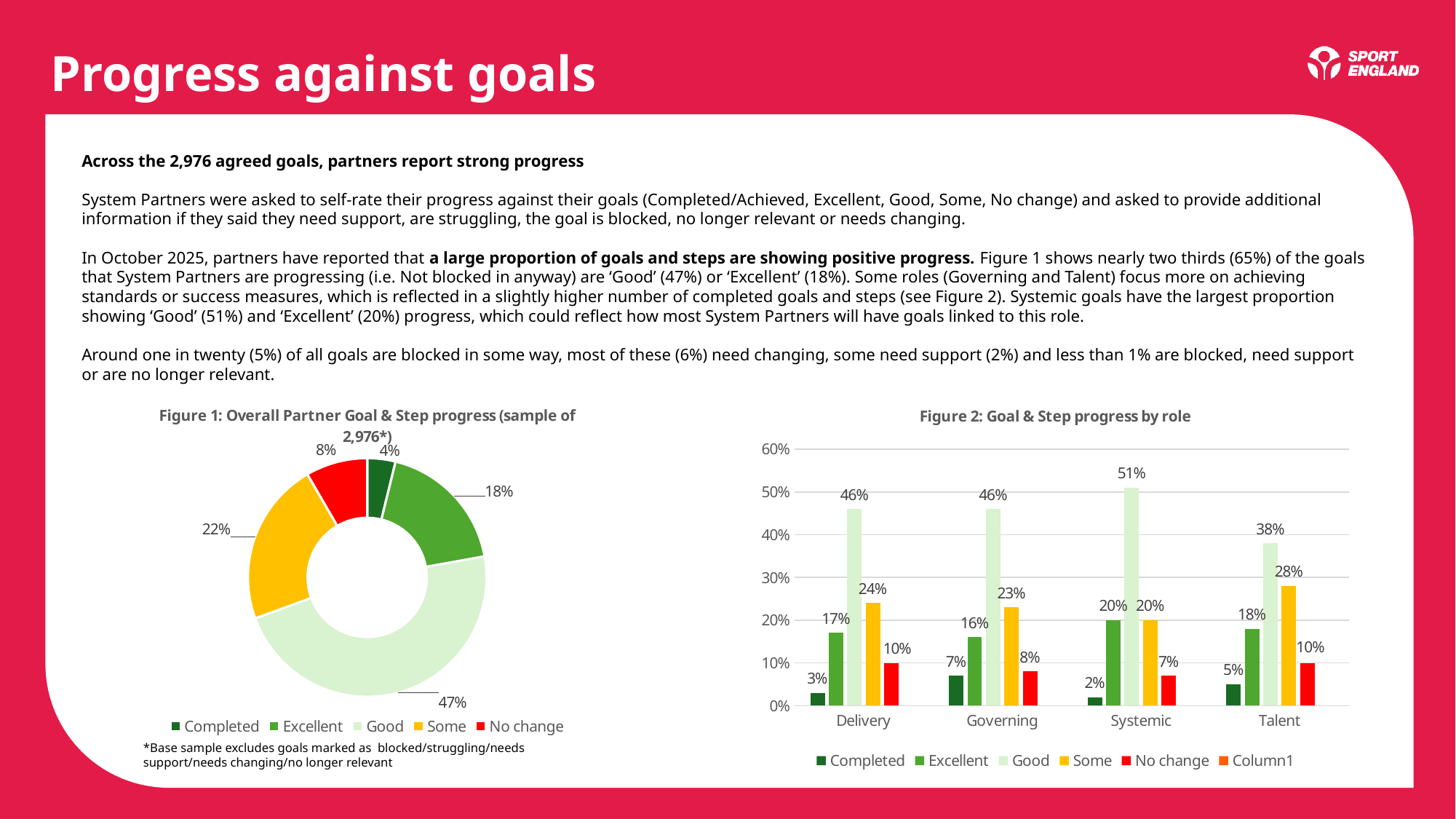
In Figure 1, what is the difference between the 'Some' and 'No change' slices? 14% In Figure 2, what is the 'Some' value for Talent? 28% In Figure 1, what percentage of goals are rated 'Completed'? 4% How many entries does the legend of Figure 2 list? 6 How many roles are shown on the x axis of Figure 2? 4 In Figure 2, which role has the lowest 'Completed' value? Systemic In Figure 2, what is the 'Good' value for Systemic? 51% In Figure 2, what is the difference between the 'Good' values for Systemic and Talent? 13% What kind of chart is Figure 1? Donut (pie) chart In Figure 1, which category has the largest slice? Good In Figure 2, which is larger: the 'Excellent' value for Delivery or for Governing? Delivery In Figure 1, what share of goals are rated 'Good'? 47%